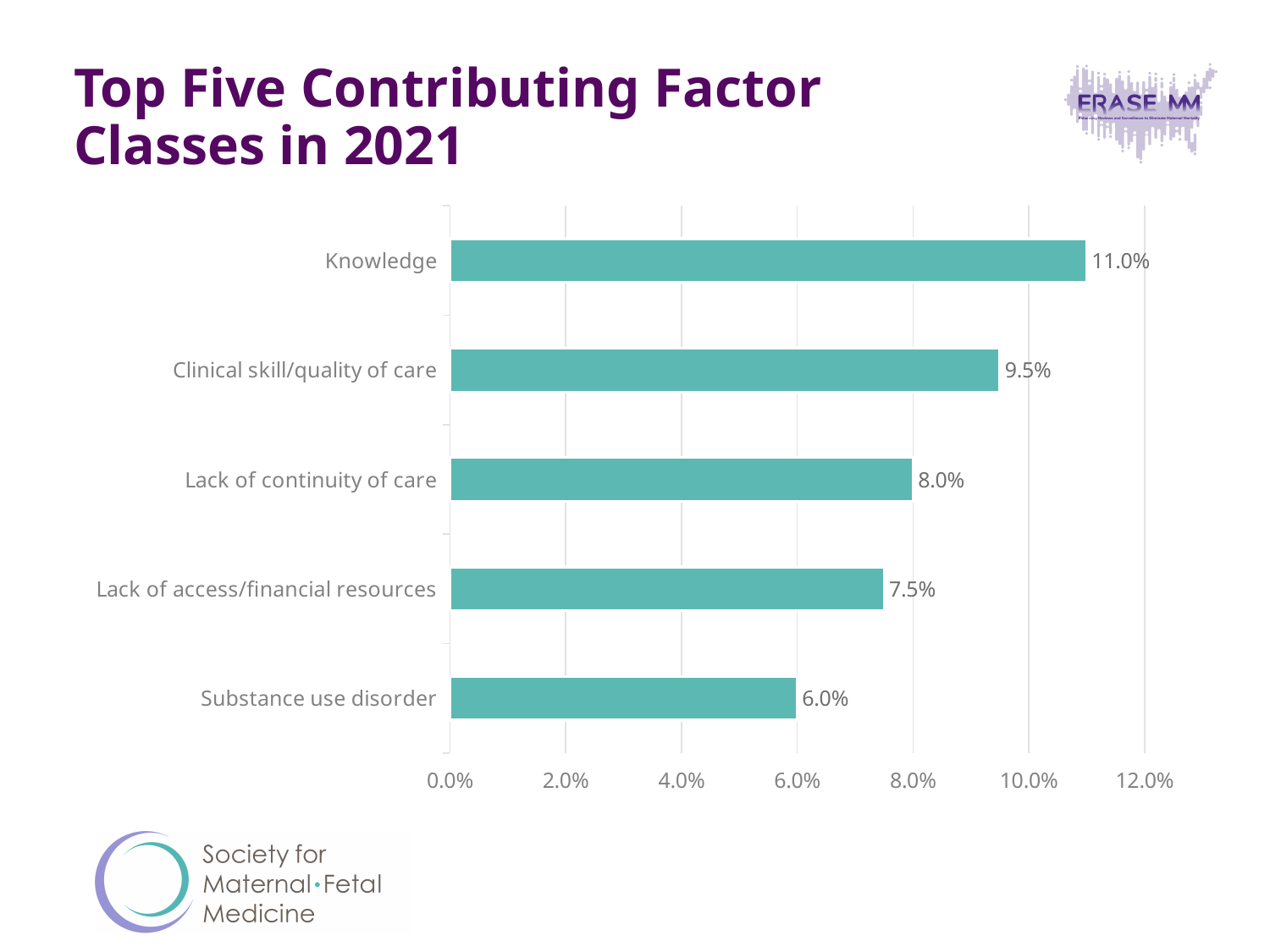
What is the value for Lack of continuity of care? 8.0% How many contributing factor classes are shown in the chart? 5 What is the value for Clinical skill/quality of care? 9.5% What kind of chart is shown on the slide? Bar chart What is the value for Lack of access/financial resources? 7.5% What is the difference between the values for Knowledge and Substance use disorder? 5.0% What is the difference between the values for Clinical skill/quality of care and Lack of continuity of care? 1.5% What is the value for Substance use disorder? 6.0% Which is larger, the value for Lack of continuity of care or the value for Lack of access/financial resources? Lack of continuity of care Which contributing factor class has the lowest value? Substance use disorder What is the value for Knowledge? 11.0% Which contributing factor class has the highest value? Knowledge